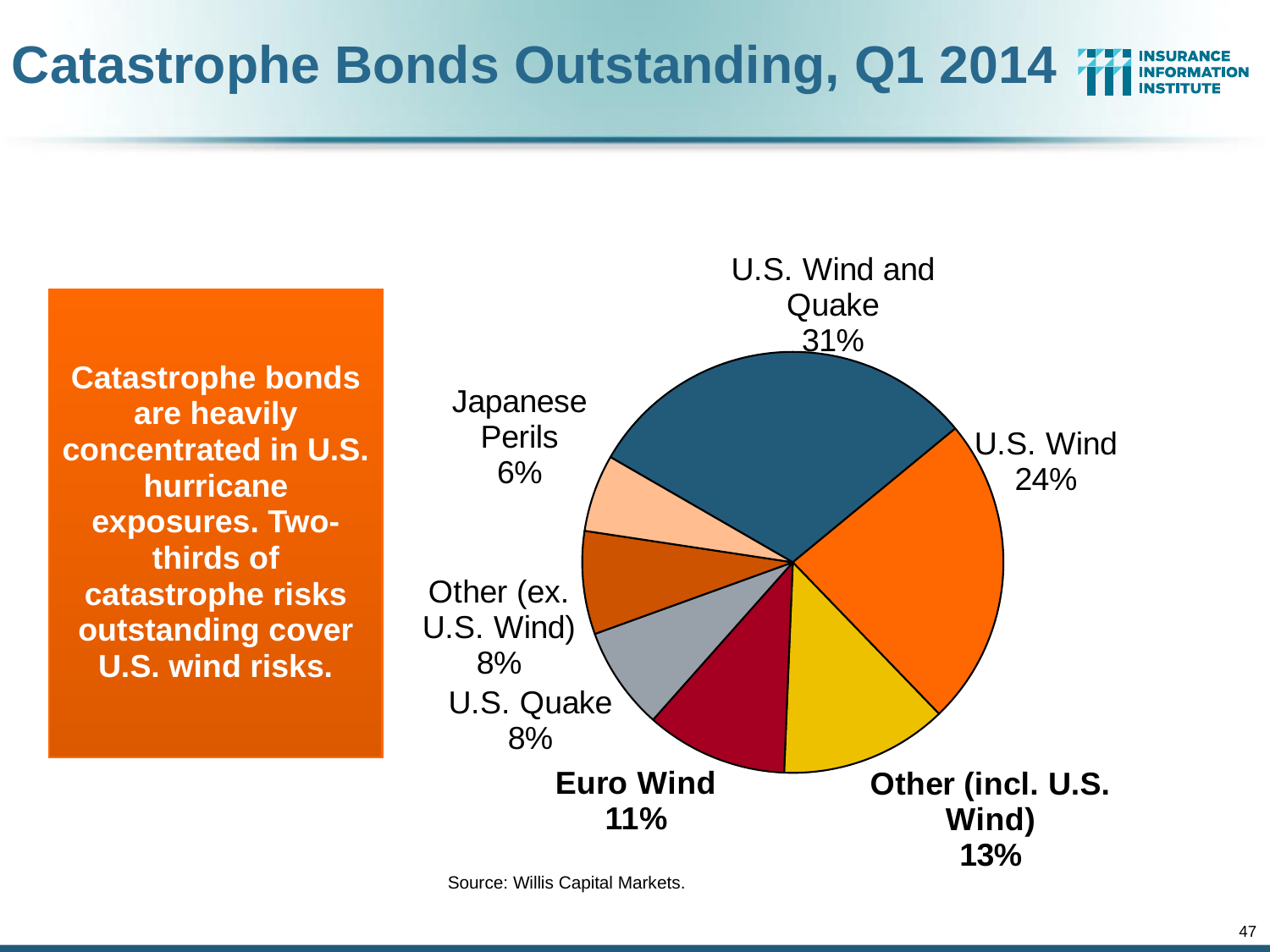
What is the difference in percentage points between U.S. Wind and Quake and U.S. Wind? 7 percentage points What percentage is shown for Other (incl. U.S. Wind)? 13% Which is larger, the share for Euro Wind or the share for U.S. Quake? Euro Wind How many slices does the pie chart have? 7 What share of the pie is U.S. Wind? 24% What is the title of the chart on the slide? Catastrophe Bonds Outstanding, Q1 2014 What share of catastrophe bonds outstanding is U.S. Wind and Quake? 31% Which category has the smallest share of the pie? Japanese Perils What percentage is shown for Euro Wind? 11% What kind of chart is shown on the slide? Pie chart Which category has the largest share of the pie? U.S. Wind and Quake What percentage is shown for Japanese Perils? 6%